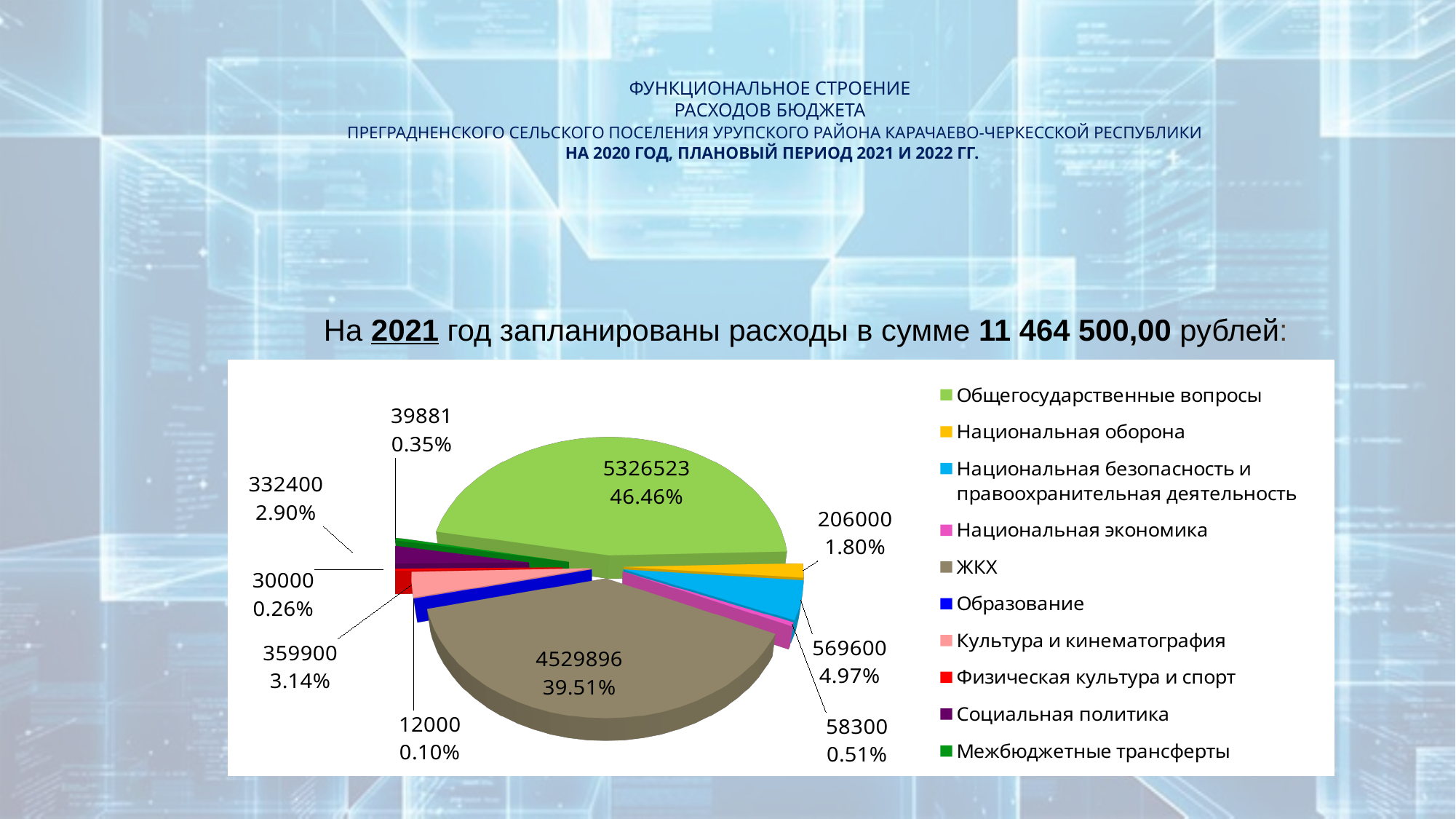
What is the difference between the values for Общегосударственные вопросы and ЖКХ? 796627 What kind of chart is shown on the slide? pie chart Which category has the largest slice of the pie chart? Общегосударственные вопросы What is the value shown for Национальная безопасность и правоохранительная деятельность? 569600 What is the value shown for Межбюджетные трансферты? 39881 Which category has the smallest slice of the pie chart? Образование What percentage share is shown for Национальная оборона? 1.80% What percentage share does ЖКХ have in the pie chart? 39.51% Which is larger, the value for Культура и кинематография or the value for Социальная политика? Культура и кинематография What is the value shown for Общегосударственные вопросы? 5326523 What total amount of planned expenditures for 2021 is stated above the chart? 11 464 500,00 рублей How many categories does the legend of the pie chart list? 10